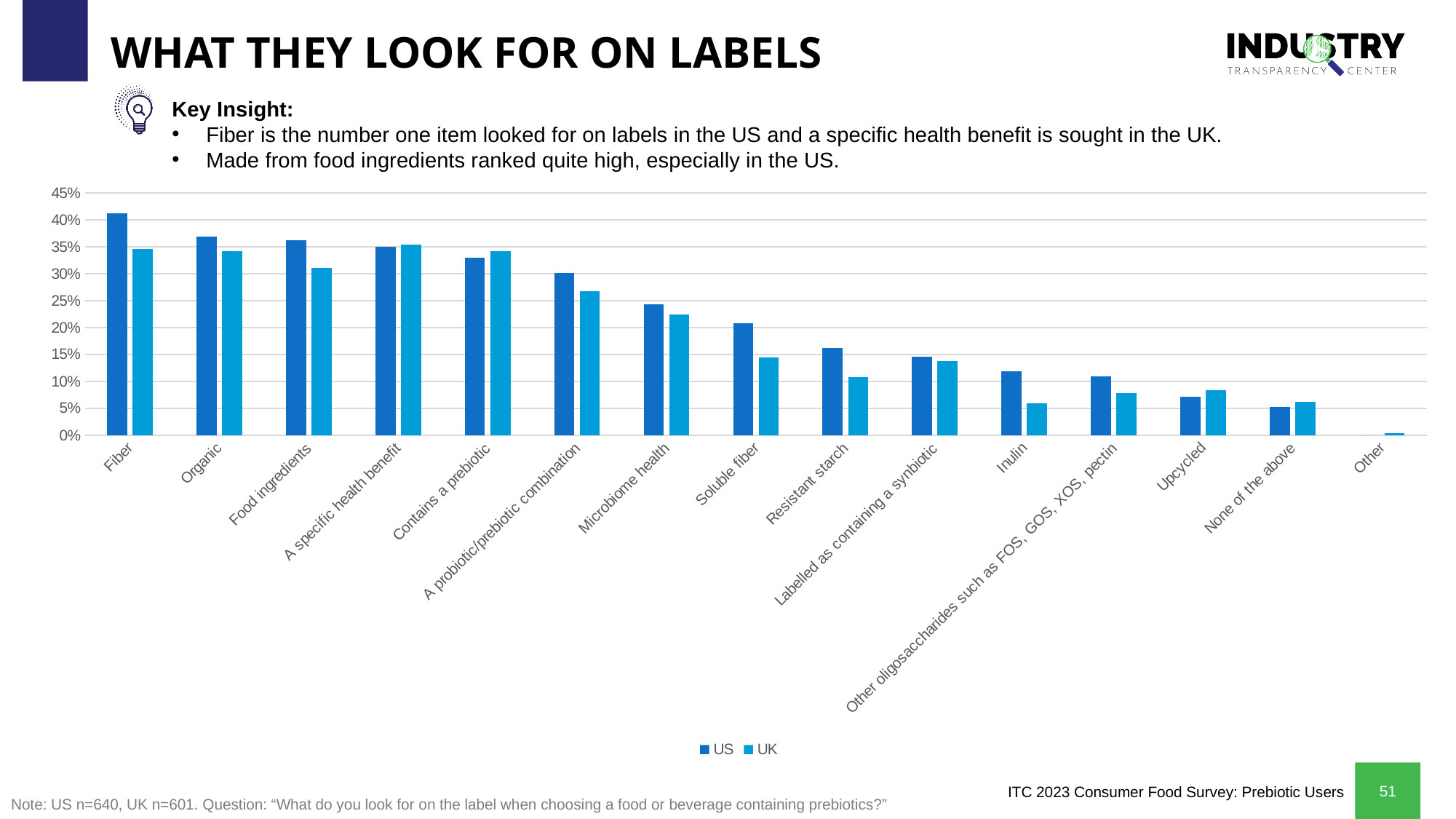
How many categories are shown on the x axis? 15 For Upcycled, which is larger, the US value or the UK value? UK Is the UK value for Inulin greater or less than 10%? less Is the US value for Organic greater or less than 35%? greater Which category has the lowest UK value? Other How many series does the legend list? 2 For Fiber, which is larger, the US value or the UK value? US What kind of chart is shown on the slide? bar chart Which category has the highest US value? Fiber Do the US values generally rise or fall moving from left to right along the x axis? fall Is the UK value for A probiotic/prebiotic combination greater or less than 30%? less